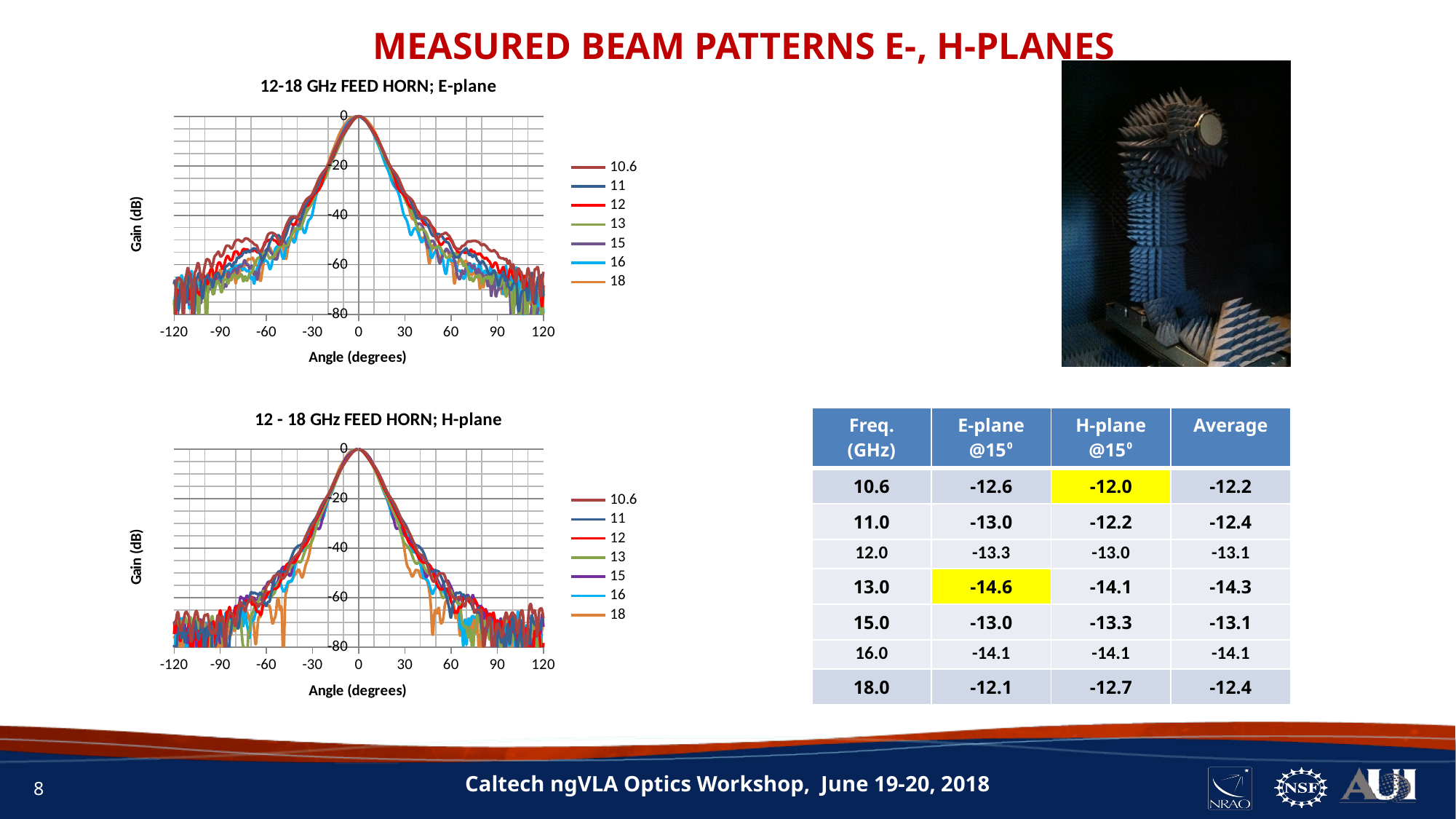
What type of chart is the '12-18 GHz FEED HORN; E-plane' chart? line chart In the '12 - 18 GHz FEED HORN; H-plane' chart, is the gain at 15 degrees greater or less than -20 dB? greater In the '12-18 GHz FEED HORN; E-plane' chart, at what angle (degrees) do the curves reach their peak gain? 0 In the '12-18 GHz FEED HORN; E-plane' chart, is the gain at 120 degrees greater or less than -60 dB? less In the '12 - 18 GHz FEED HORN; H-plane' chart, do the curves rise or fall as the angle increases from -120 to 0 degrees? rise In the '12 - 18 GHz FEED HORN; H-plane' chart, what is the peak gain (dB) reached by the curves at 0 degrees? 0 In the '12-18 GHz FEED HORN; E-plane' chart, is the gain at 0 degrees greater or less than the gain at 60 degrees? greater What is the first series listed in the legend of the '12-18 GHz FEED HORN; E-plane' chart? 10.6 In the '12-18 GHz FEED HORN; E-plane' chart, do the curves rise or fall as the angle increases from 0 to 120 degrees? fall How many series does the legend of the '12 - 18 GHz FEED HORN; H-plane' chart list? 7 What is the x-axis label of the '12 - 18 GHz FEED HORN; H-plane' chart? Angle (degrees) How many series does the legend of the '12-18 GHz FEED HORN; E-plane' chart list? 7